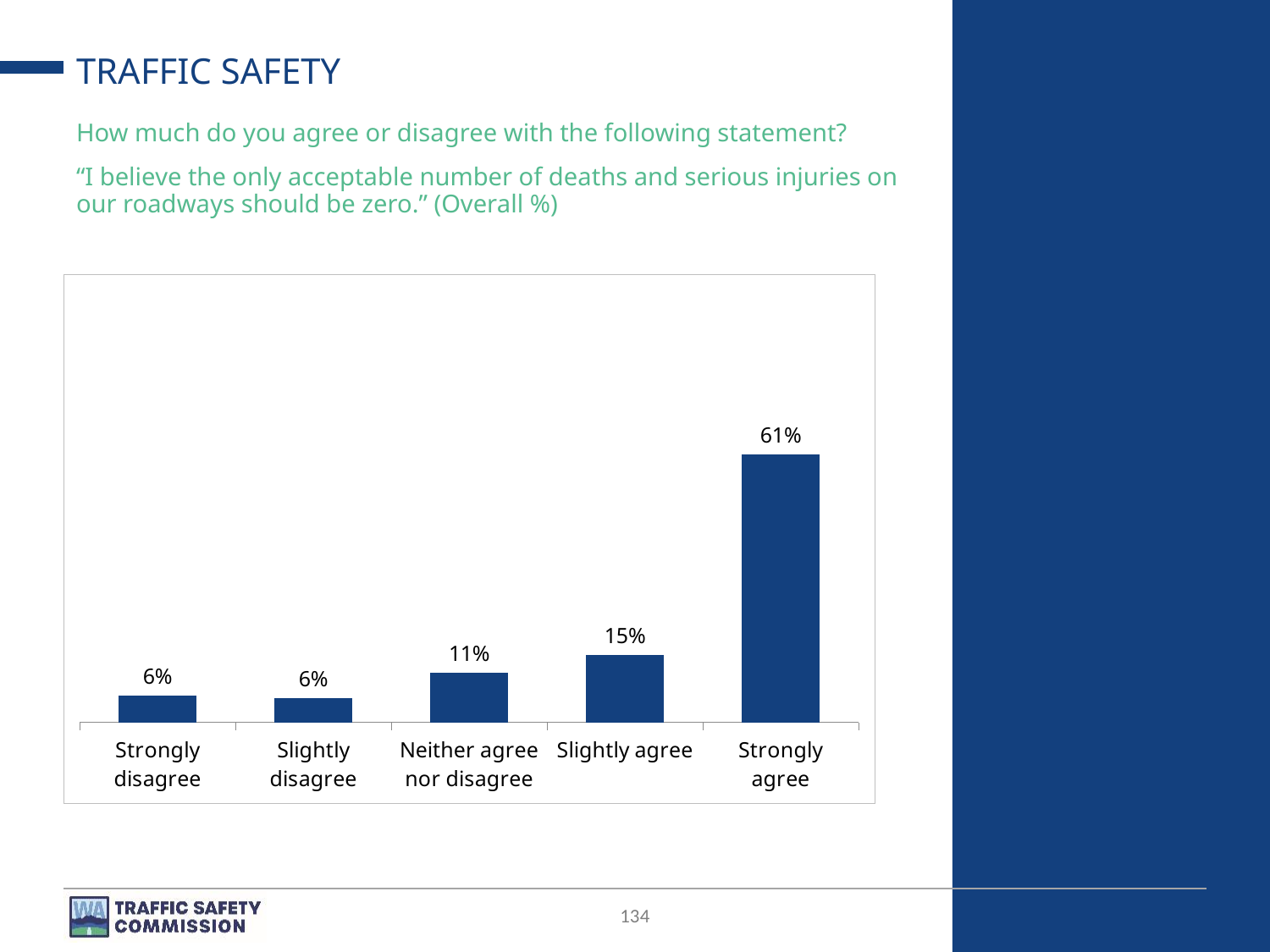
What is the difference in percentage points between Strongly agree and Slightly agree? 46 What percentage of respondents strongly disagree? 6% Which is larger, the percentage for Slightly agree or for Neither agree nor disagree? Slightly agree What is the combined percentage for Strongly disagree and Slightly disagree? 12% What percentage of respondents strongly agree with the statement? 61% Which response category has the highest percentage? Strongly agree What percentage of respondents neither agree nor disagree? 11% What is the difference in percentage points between Slightly agree and Neither agree nor disagree? 4 How many response categories are shown on the chart? 5 Do the values generally rise or fall moving from Strongly disagree to Strongly agree? Rise What type of chart is shown on the slide? Bar chart What percentage of respondents slightly agree? 15%